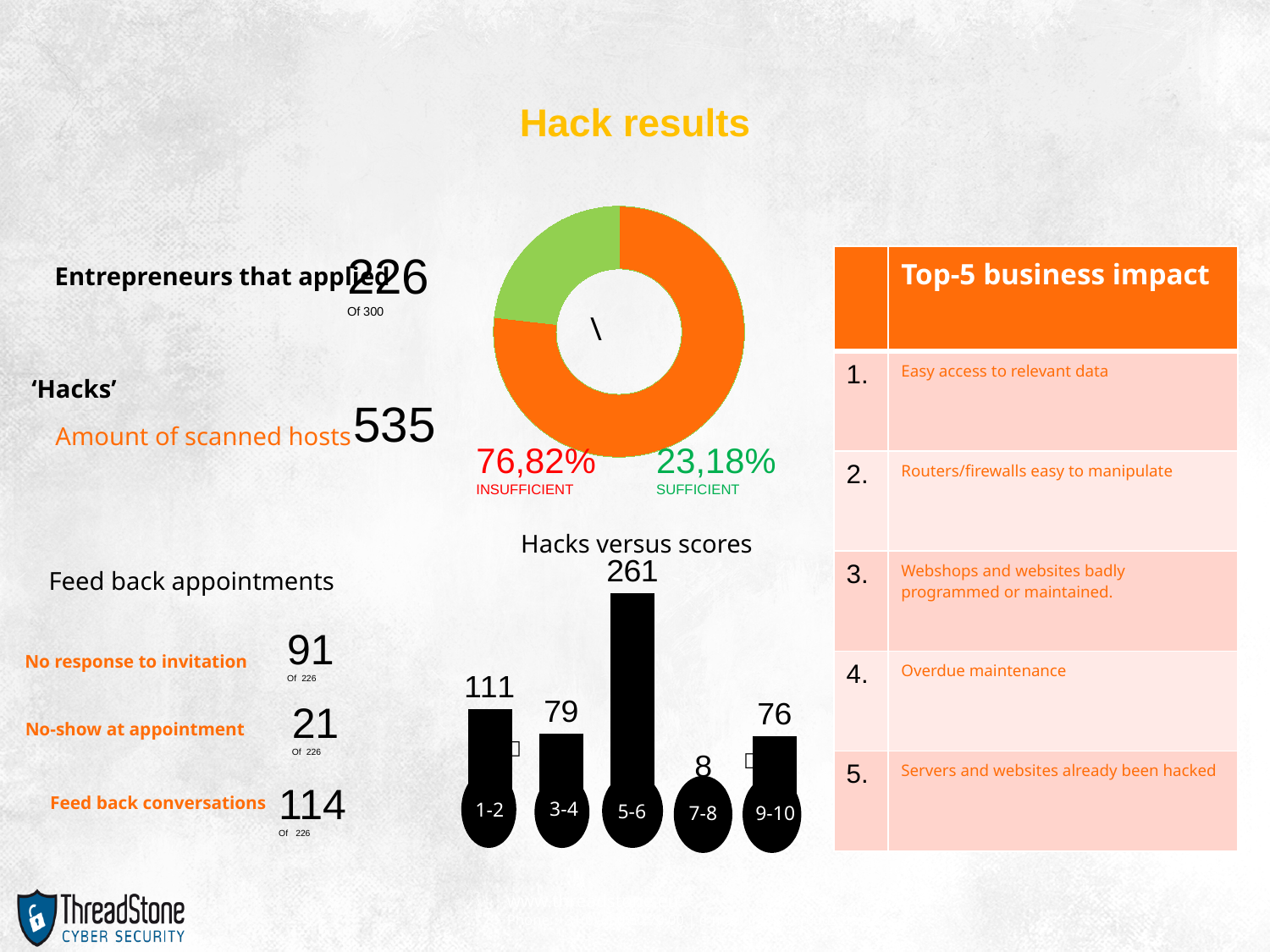
In the 'Hacks versus scores' chart, what is the value for the 7-8 score range? 8 In the 'Hacks versus scores' chart, what is the value for the 1-2 score range? 111 In the 'Hacks versus scores' chart, which score range has the lowest value? 7-8 In the 'Hacks versus scores' chart, what is the difference between the values for 5-6 and 1-2? 150 In the 'Hacks versus scores' chart, what is the value for the 5-6 score range? 261 In the donut chart, what share is labelled INSUFFICIENT? 76,82% In the donut chart, what share is labelled SUFFICIENT? 23,18% In the 'Hacks versus scores' chart, which is larger, the value for 3-4 or the value for 9-10? 3-4 What kind of chart is the 'Hacks versus scores' chart? bar chart In the donut chart, which colour represents the SUFFICIENT share? green How many score ranges are shown in the 'Hacks versus scores' chart? 5 In the 'Hacks versus scores' chart, which score range has the highest value? 5-6